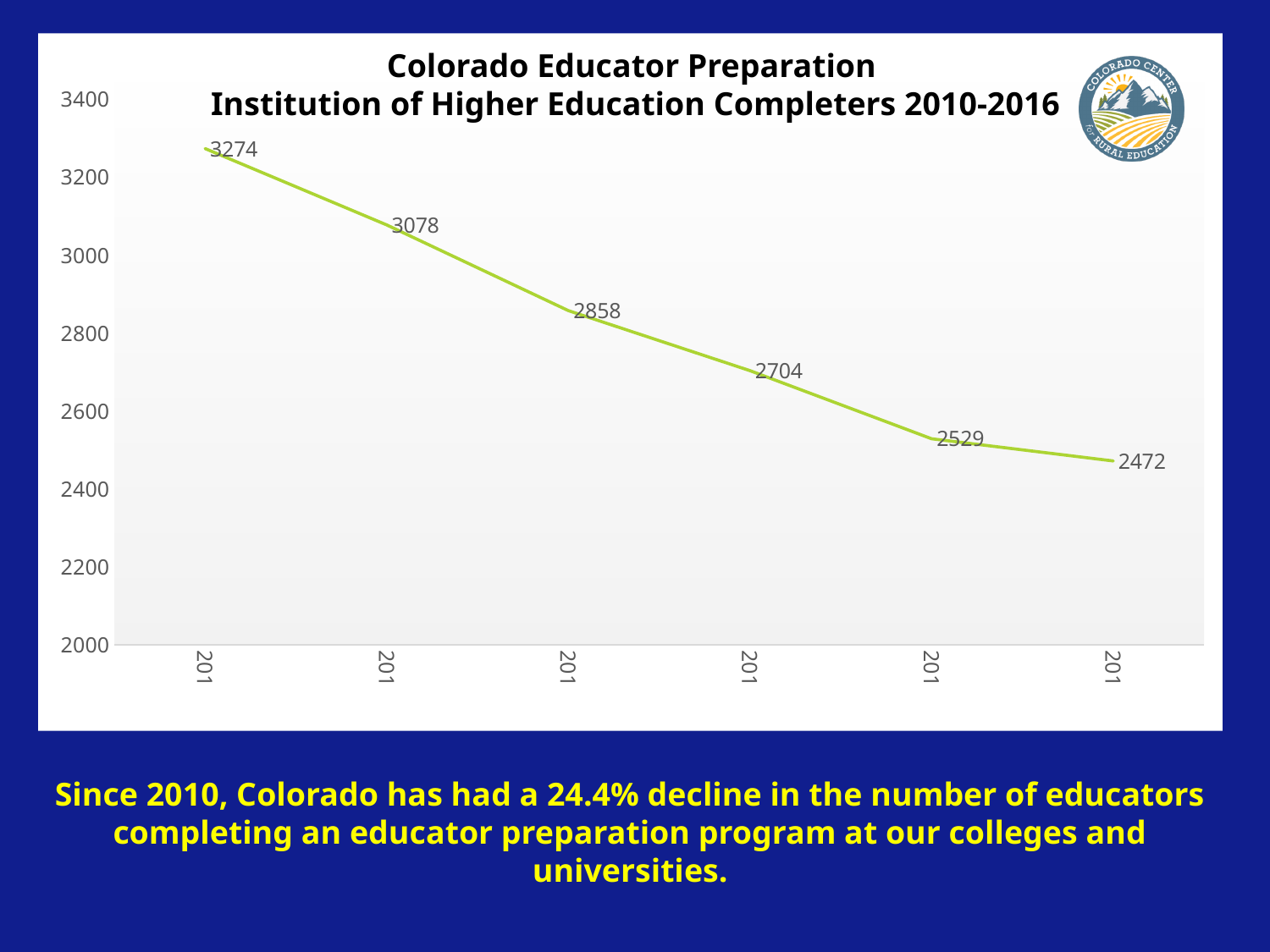
Do the values rise or fall from left to right along the x axis? fall Which is larger, the second data point or the fourth data point? the second data point (3078) How many data points are plotted on the line? 6 What type of chart is shown on the slide? line chart What is the value of the last (rightmost) data point on the line? 2472 What is the lowest value plotted on the chart? 2472 What is the difference between the first data point (3274) and the last data point (2472)? 802 What is the value of the third data point from the left? 2858 What is the value of the fifth data point from the left? 2529 What is the highest value plotted on the chart? 3274 What is the value of the first (leftmost) data point on the line? 3274 What is the title of the chart? Colorado Educator Preparation Institution of Higher Education Completers 2010-2016